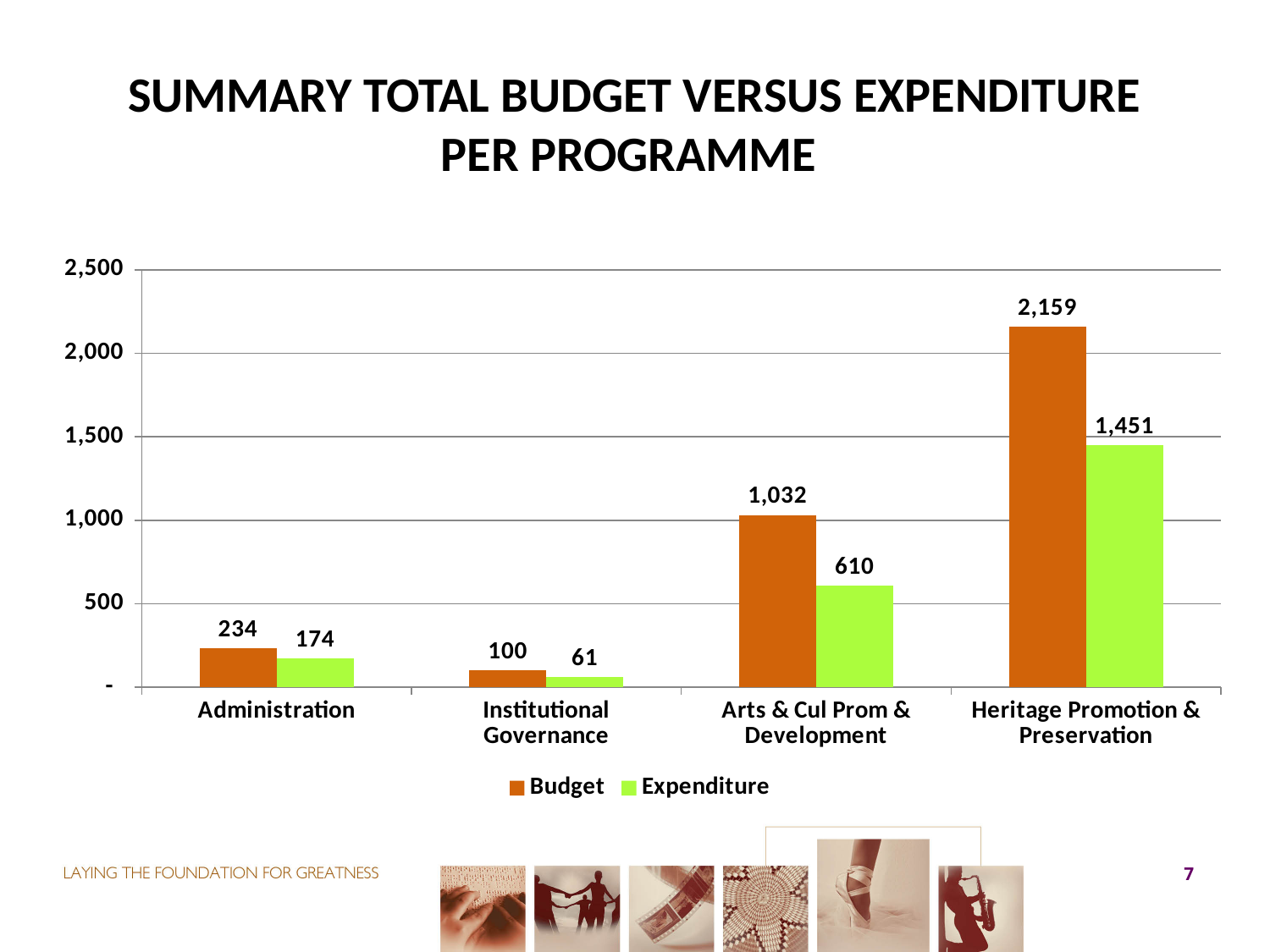
What is the Expenditure value for Institutional Governance? 61 What kind of chart is shown on the slide? bar chart Which is larger for Administration, Budget or Expenditure? Budget What is the Expenditure value for Heritage Promotion & Preservation? 1,451 What colour are the Expenditure bars? green What is the Budget value for Administration? 234 Is the Budget value for Heritage Promotion & Preservation greater or less than 2,000? greater Which programme has the lowest Expenditure? Institutional Governance What is the difference between Budget and Expenditure for Arts & Cul Prom & Development? 422 How many series does the legend list? 2 How many programmes are shown on the x axis? 4 Which programme has the highest Budget? Heritage Promotion & Preservation